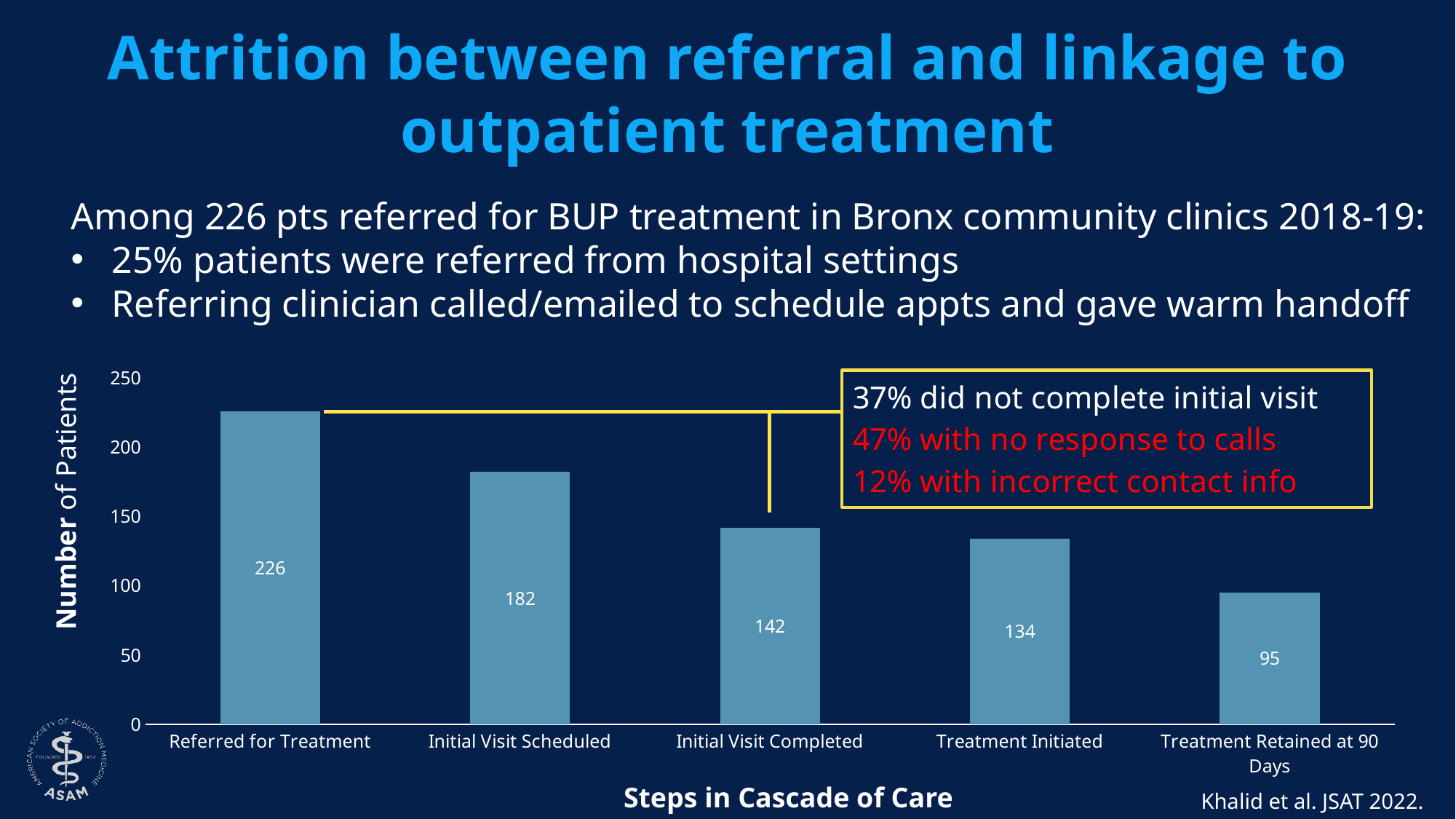
How many patients were Referred for Treatment? 226 Is the value for Initial Visit Completed greater or less than 150? less What kind of chart is shown on the slide? bar chart Which step in the cascade of care has the highest number of patients? Referred for Treatment Which is larger, the value for Initial Visit Scheduled or the value for Treatment Initiated? Initial Visit Scheduled What is the difference between Treatment Initiated and Treatment Retained at 90 Days? 39 Which step in the cascade of care has the lowest number of patients? Treatment Retained at 90 Days Do the values rise or fall along the x axis from Referred for Treatment to Treatment Retained at 90 Days? fall What is the difference between the number of patients Referred for Treatment and the number with Initial Visit Completed? 84 What is the value for Initial Visit Scheduled? 182 How many steps in the cascade of care are shown on the x axis? 5 What is the value for Treatment Retained at 90 Days? 95